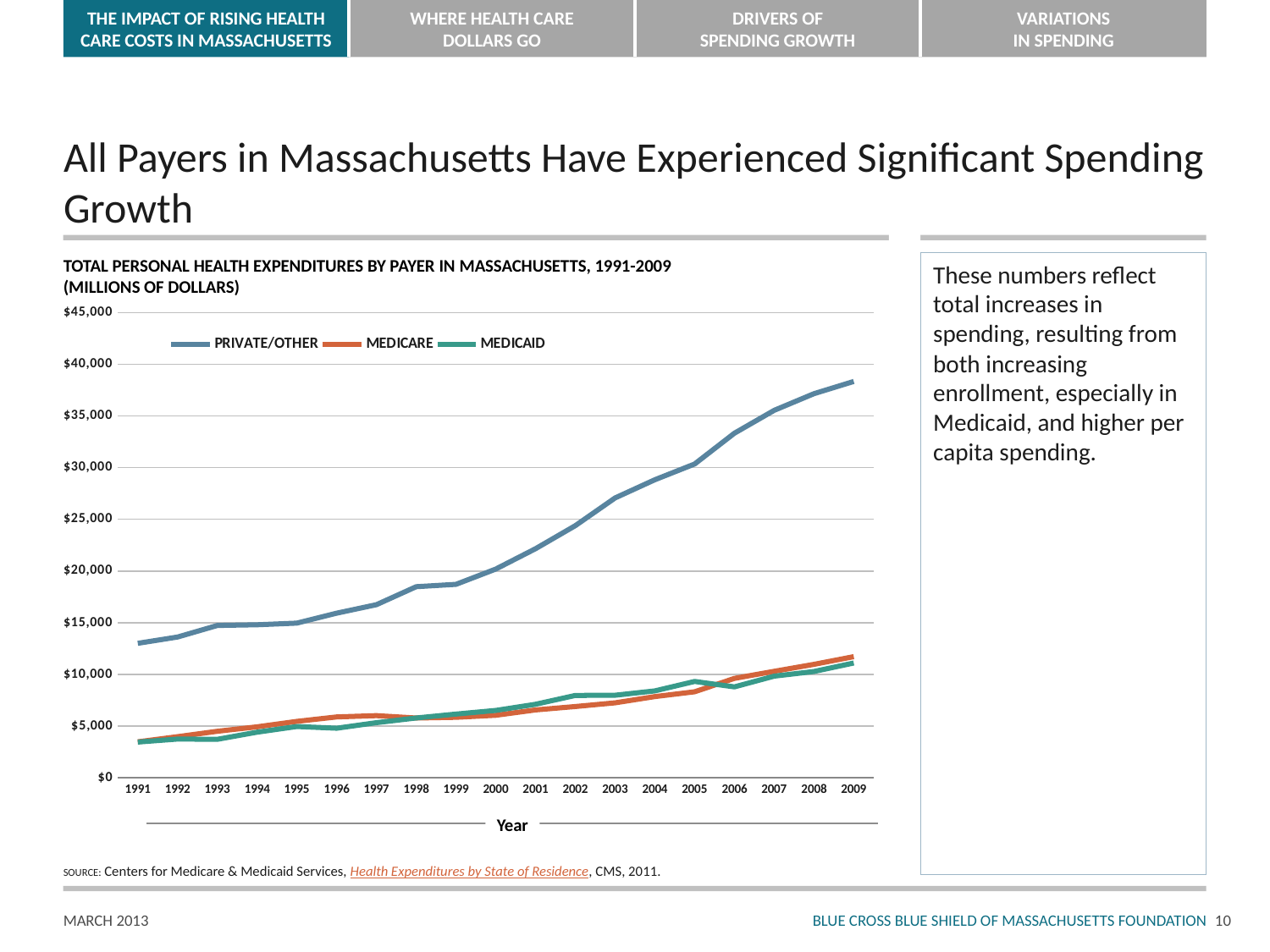
Is the PRIVATE/OTHER value for 2009 greater or less than $35,000? greater How many series does the legend list? 3 What is the label on the x axis of the chart? Year In 2009, which is larger: PRIVATE/OTHER or MEDICARE spending? PRIVATE/OTHER Does PRIVATE/OTHER spending rise or fall from 1991 to 2009? rise What kind of chart is shown on the slide? line chart How many years are plotted along the x axis? 19 Which payer has the highest spending in 2009? PRIVATE/OTHER Is the MEDICAID value for 1991 greater or less than $5,000? less Is the MEDICARE value for 2009 greater or less than $10,000? greater